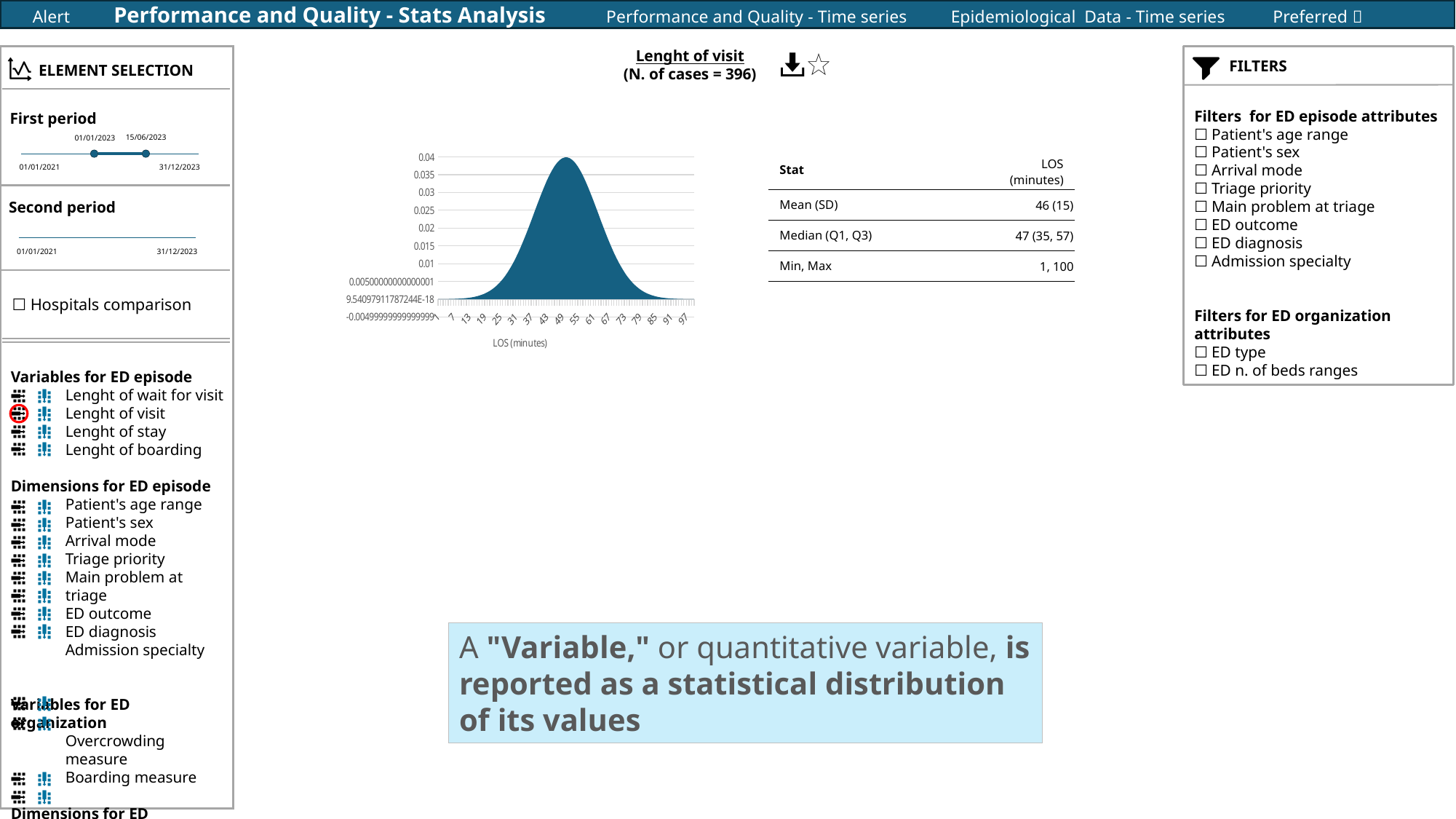
Does the curve rise or fall as LOS increases from 1 to 49 minutes? rise What kind of chart is shown for Lenght of visit? area chart According to the stats table next to the chart, what is the Mean (SD) of LOS in minutes? 46 (15) Does the curve rise or fall as LOS increases from 55 to 97 minutes? fall Is the value of the curve at LOS = 97 minutes greater or less than 0.01? less What is the label of the x axis of the chart? LOS (minutes) What is the title of the chart? Lenght of visit According to the stats table next to the chart, what is the Median (Q1, Q3) of LOS in minutes? 47 (35, 57) According to the stats table next to the chart, what are the Min and Max of LOS in minutes? 1, 100 Is the value of the curve at LOS = 1 minute greater or less than 0.01? less How many cases does the chart title report? 396 Is the peak of the distribution curve greater or less than 0.03? greater